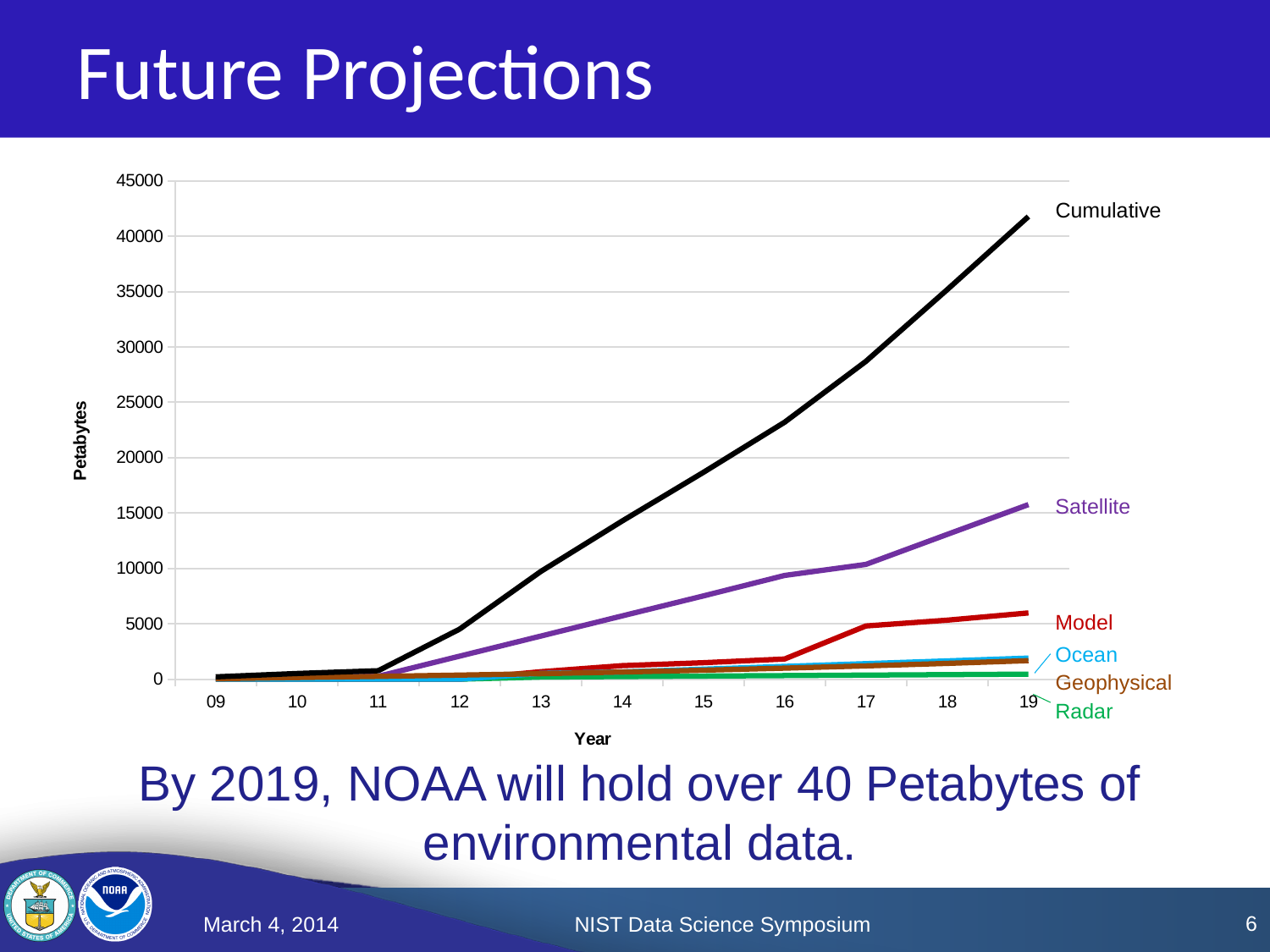
What is the label of the y axis? Petabytes Is the Cumulative value in year 19 greater or less than 40000? greater Is the Model value in year 19 greater or less than 5000? greater Does the Cumulative series rise or fall from year 09 to year 19? rise Is the Cumulative value in year 16 greater or less than 20000? greater What kind of chart is shown on the slide? line chart How many years are marked along the x axis? 11 Which series has the highest value in year 19? Cumulative How many series are labelled on the chart? 6 Which series has the lowest value in year 19? Radar In year 19, which is larger, the Satellite value or the Model value? Satellite